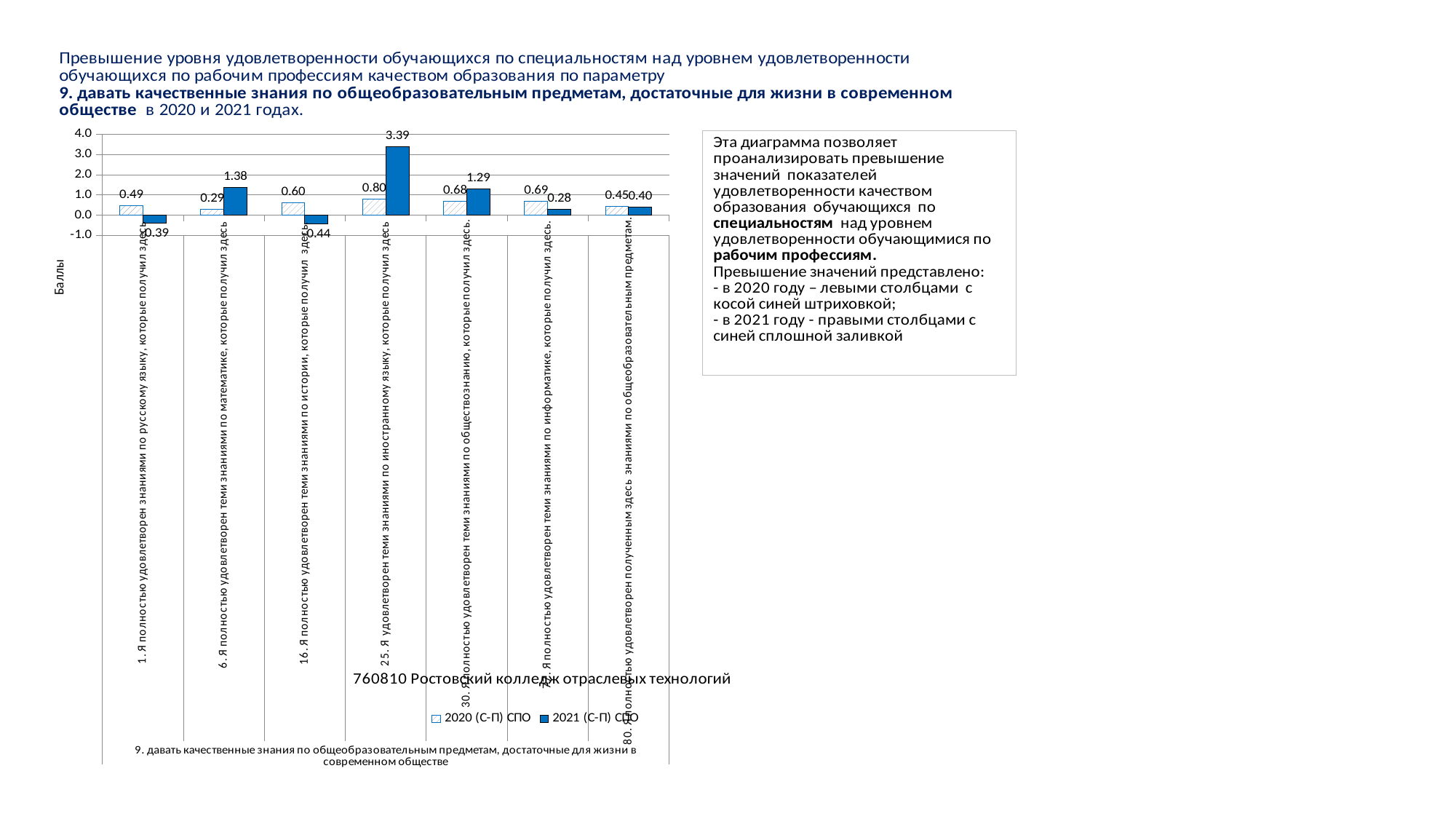
What is the difference between the 2021 and 2020 values for category 6 (математике)? 1.09 How many categories are shown on the x axis? 7 What is the label of the vertical axis? Баллы Which category has the lowest 2020 (С-П) СПО value? 6. Я полностью удовлетворен теми знаниями по математике, которые получил здесь What is the 2021 (С-П) СПО value for category 16 (истории)? -0.44 What kind of chart is shown on the slide? Bar chart What is the 2021 (С-П) СПО value for category 25 (иностранному языку)? 3.39 Which category has the highest 2021 (С-П) СПО value? 25. Я удовлетворен теми знаниями по иностранному языку, которые получил здесь What is the 2020 (С-П) СПО value for category 1 (русскому языку)? 0.49 What is the 2021 (С-П) СПО value for category 30 (обществознанию)? 1.29 How many series does the legend list? 2